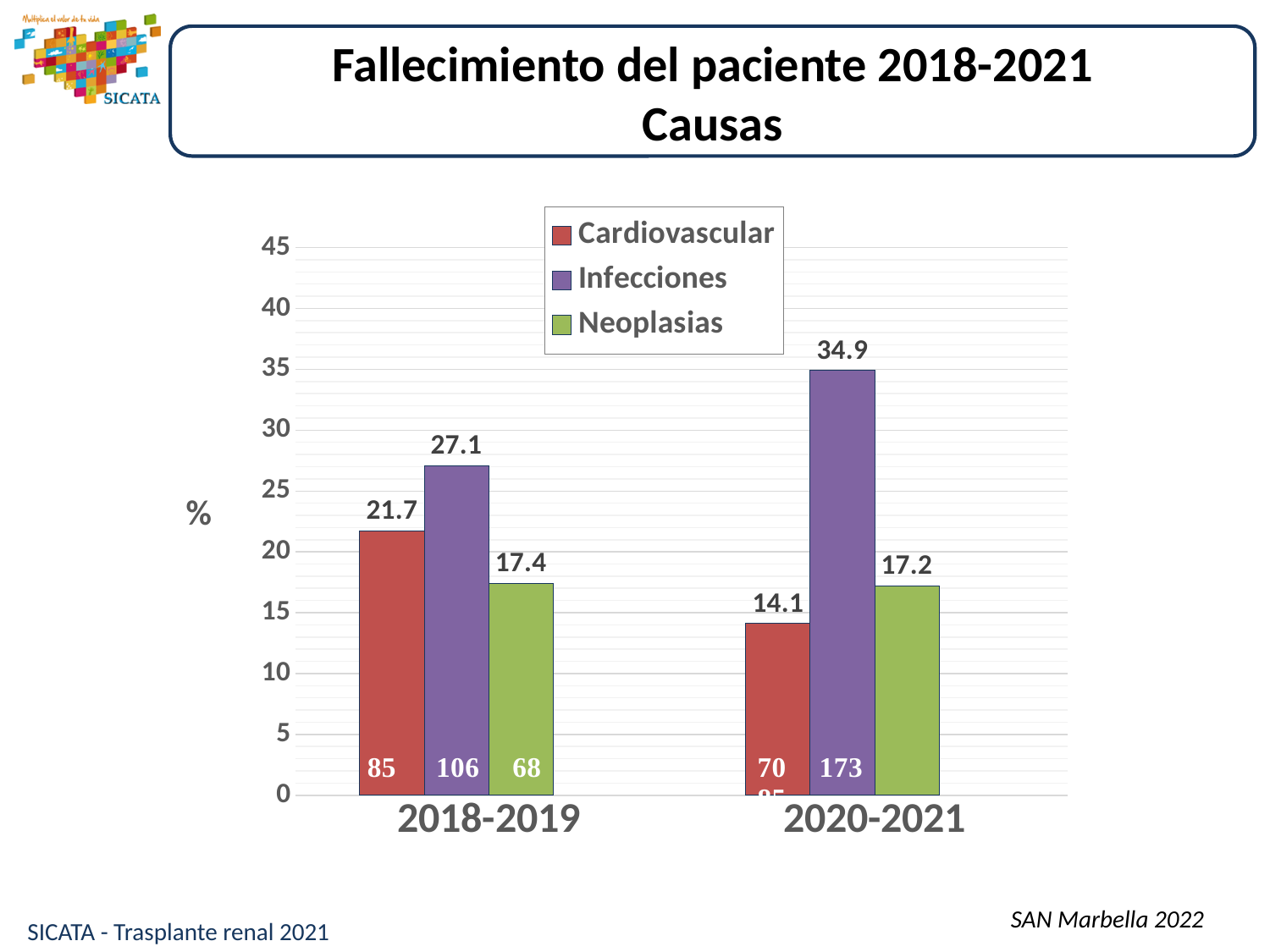
What is the percentage for Cardiovascular in 2018-2019? 21.7 What number is printed inside the Infecciones bar for 2020-2021? 173 What is the difference between the Infecciones percentage in 2020-2021 and in 2018-2019? 7.8 What is the percentage for Infecciones in 2020-2021? 34.9 How many series does the legend list? 3 Which cause has the lowest percentage in 2018-2019? Neoplasias Which is larger, the Cardiovascular percentage in 2018-2019 or in 2020-2021? 2018-2019 Does the Cardiovascular percentage rise or fall from 2018-2019 to 2020-2021? Fall How many period categories are shown on the x axis? 2 What is the percentage for Neoplasias in 2020-2021? 17.2 What type of chart is shown on the slide? Bar chart Which cause has the highest percentage in 2020-2021? Infecciones